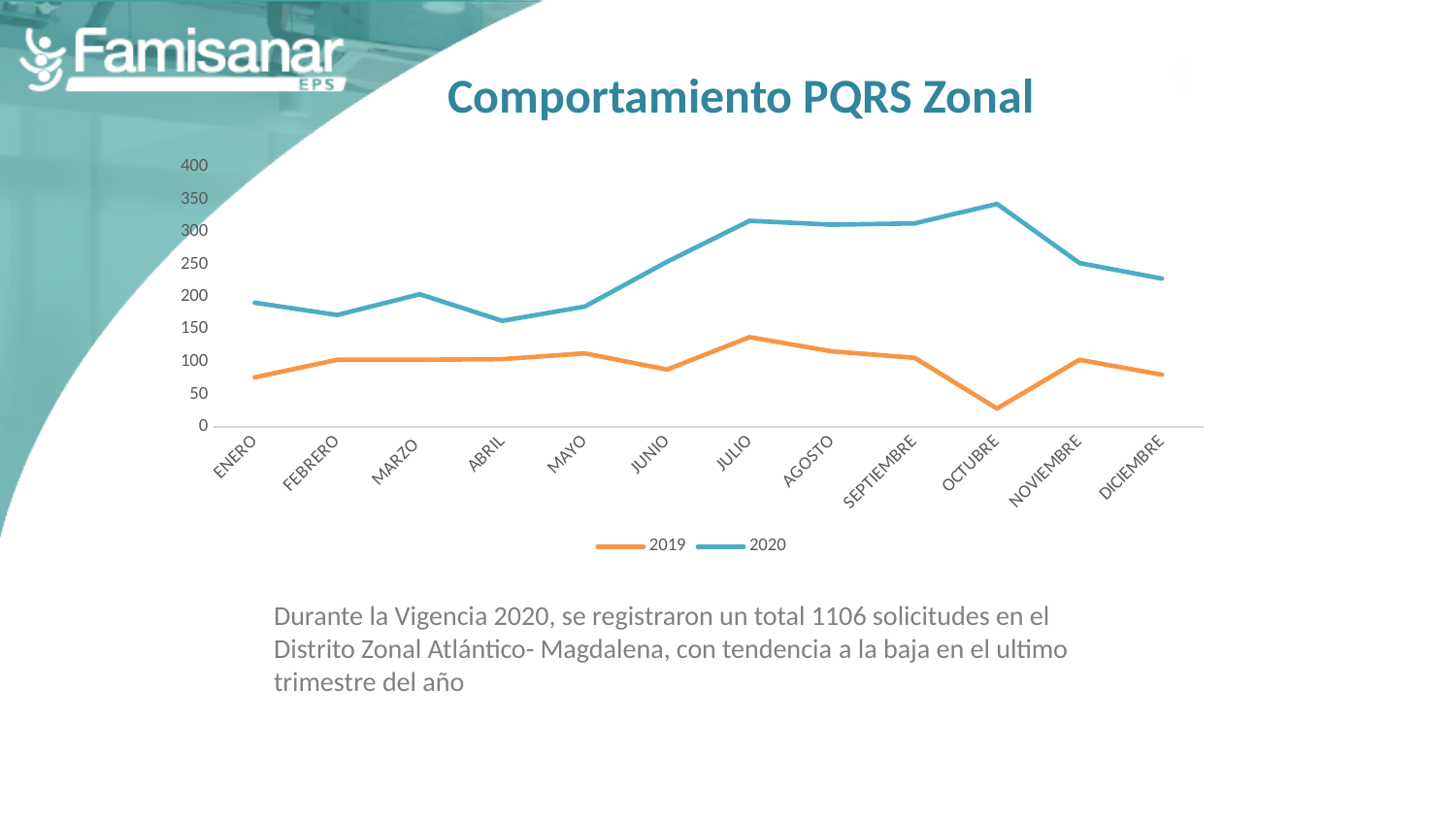
What is the title of the chart? Comportamiento PQRS Zonal How many months are shown on the x axis of the chart? 12 Is the 2019 value for OCTUBRE greater or less than 50? less How many series does the chart legend list? 2 Which series has the larger value in JULIO, 2019 or 2020? 2020 Does the 2020 series rise or fall from OCTUBRE to DICIEMBRE? fall In which month does the 2019 series reach its highest value? JULIO Is the 2020 value for OCTUBRE greater or less than 300? greater Is the 2020 value for ABRIL greater or less than 200? less In which month does the 2020 series reach its highest value? OCTUBRE In which month does the 2019 series reach its lowest value? OCTUBRE What kind of chart is shown on the slide? line chart